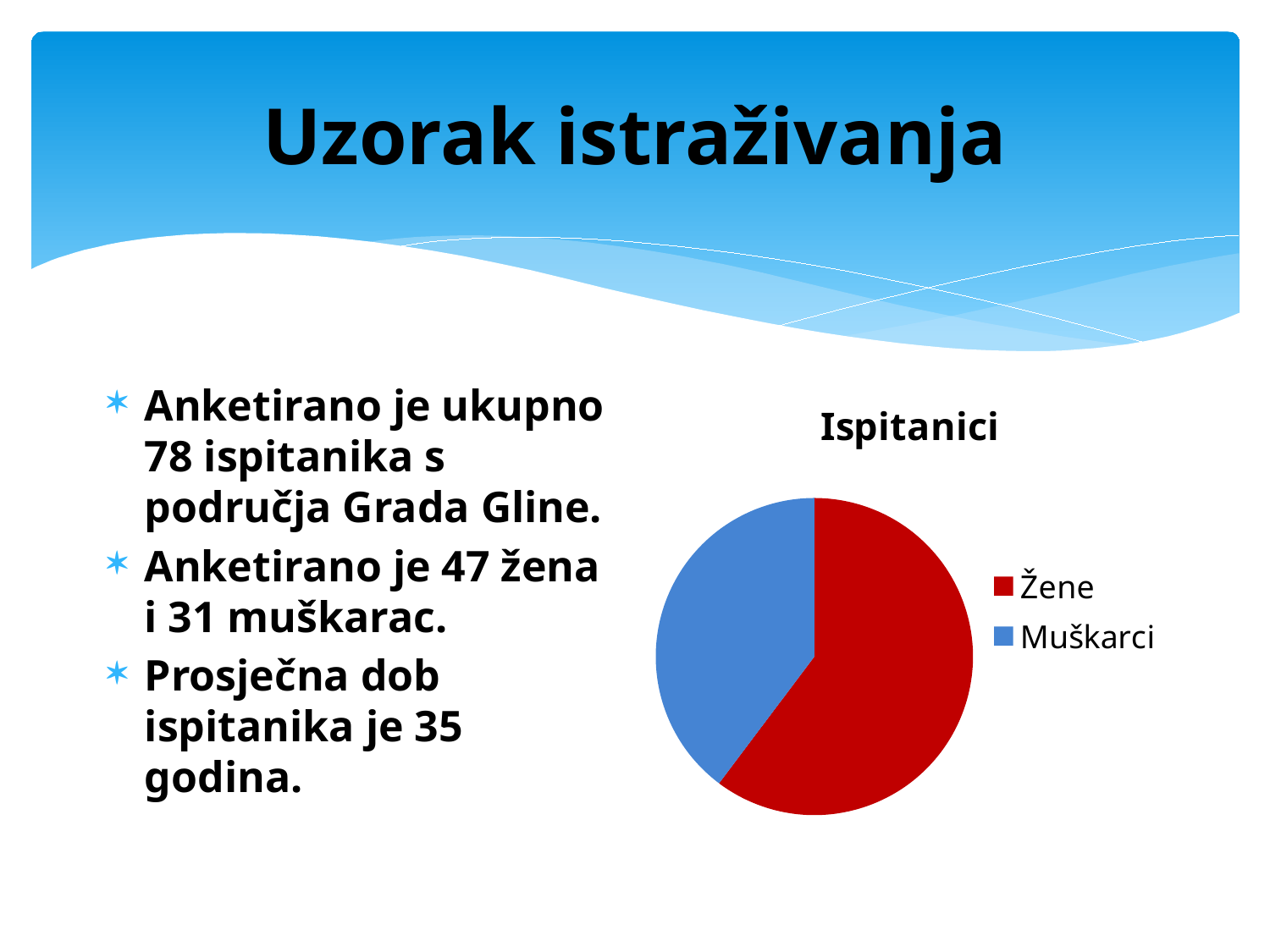
What colour is the Žene slice in the pie chart? red Which slice is larger, Žene or Muškarci? Žene Is the Žene slice greater or less than half of the pie? greater Which category has the largest slice of the pie? Žene Is the Muškarci slice greater or less than half of the pie? less What is the title of the chart? Ispitanici Which category has the smallest slice of the pie? Muškarci How many entries does the chart legend list? 2 How many slices does the pie chart have? 2 What kind of chart is shown on the slide? pie chart